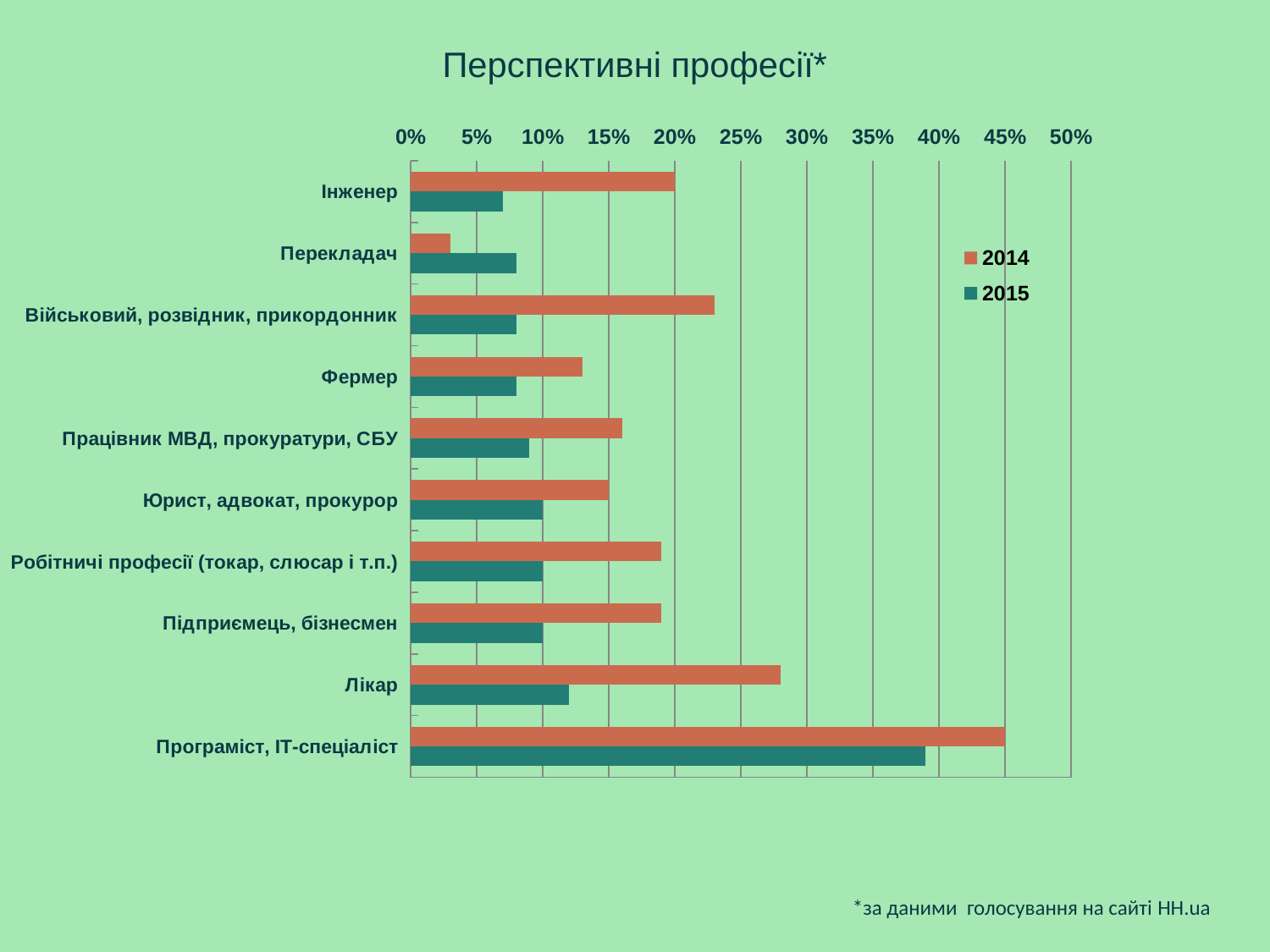
For Лікар, which year has the larger value, 2014 or 2015? 2014 Which profession has the lowest value for 2014? Перекладач Which profession has the highest value for 2014? Програміст, ІТ-спеціаліст How many professions (categories) are shown on the chart? 10 What is the title of the chart? Перспективні професії* What kind of chart is shown on the slide? bar chart Is the 2015 value for Програміст, ІТ-спеціаліст greater or less than 35%? greater Is the 2014 value for Перекладач greater or less than 5%? less Which profession has the highest value for 2015? Програміст, ІТ-спеціаліст For Перекладач, which year has the larger value, 2014 or 2015? 2015 Is the 2014 value for Лікар greater or less than 25%? greater How many series does the legend list? 2